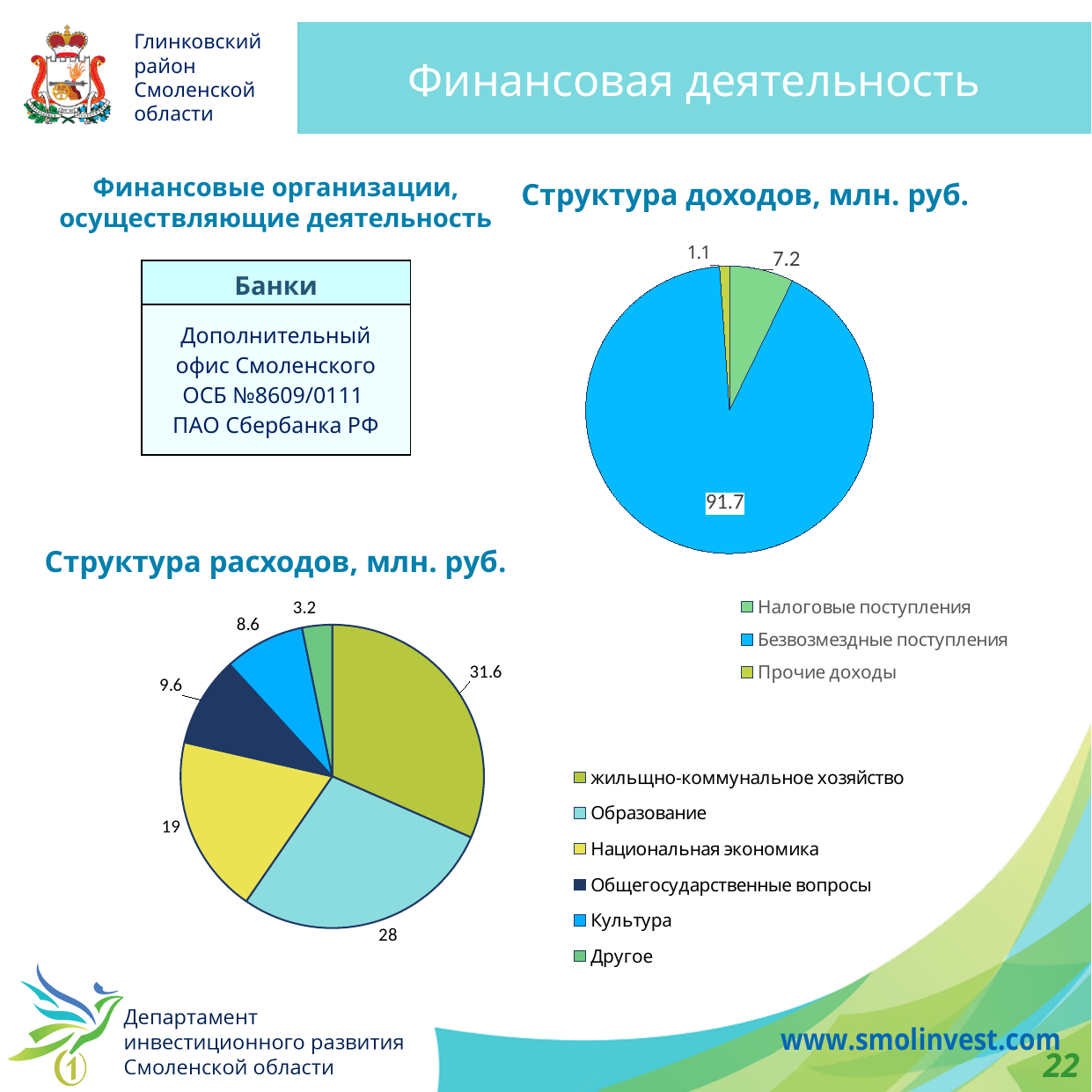
How many categories are shown in the chart 'Структура расходов, млн. руб.'? 6 In the chart 'Структура доходов, млн. руб.', what is the value for Безвозмездные поступления? 91.7 In the chart 'Структура доходов, млн. руб.', what is the difference between Безвозмездные поступления and Налоговые поступления? 84.5 In the chart 'Структура расходов, млн. руб.', what is the difference between жильщно-коммунальное хозяйство and Образование? 3.6 In the chart 'Структура расходов, млн. руб.', which is larger: Национальная экономика or Общегосударственные вопросы? Национальная экономика In the chart 'Структура расходов, млн. руб.', which category has the largest value? жильщно-коммунальное хозяйство In the chart 'Структура доходов, млн. руб.', which category has the smallest value? Прочие доходы In the chart 'Структура расходов, млн. руб.', what is the value for Образование? 28 In the chart 'Структура доходов, млн. руб.', what is the value for Налоговые поступления? 7.2 What type of chart is 'Структура расходов, млн. руб.'? Pie chart How many categories does the legend of the chart 'Структура доходов, млн. руб.' list? 3 In the chart 'Структура расходов, млн. руб.', what is the value for Культура? 8.6